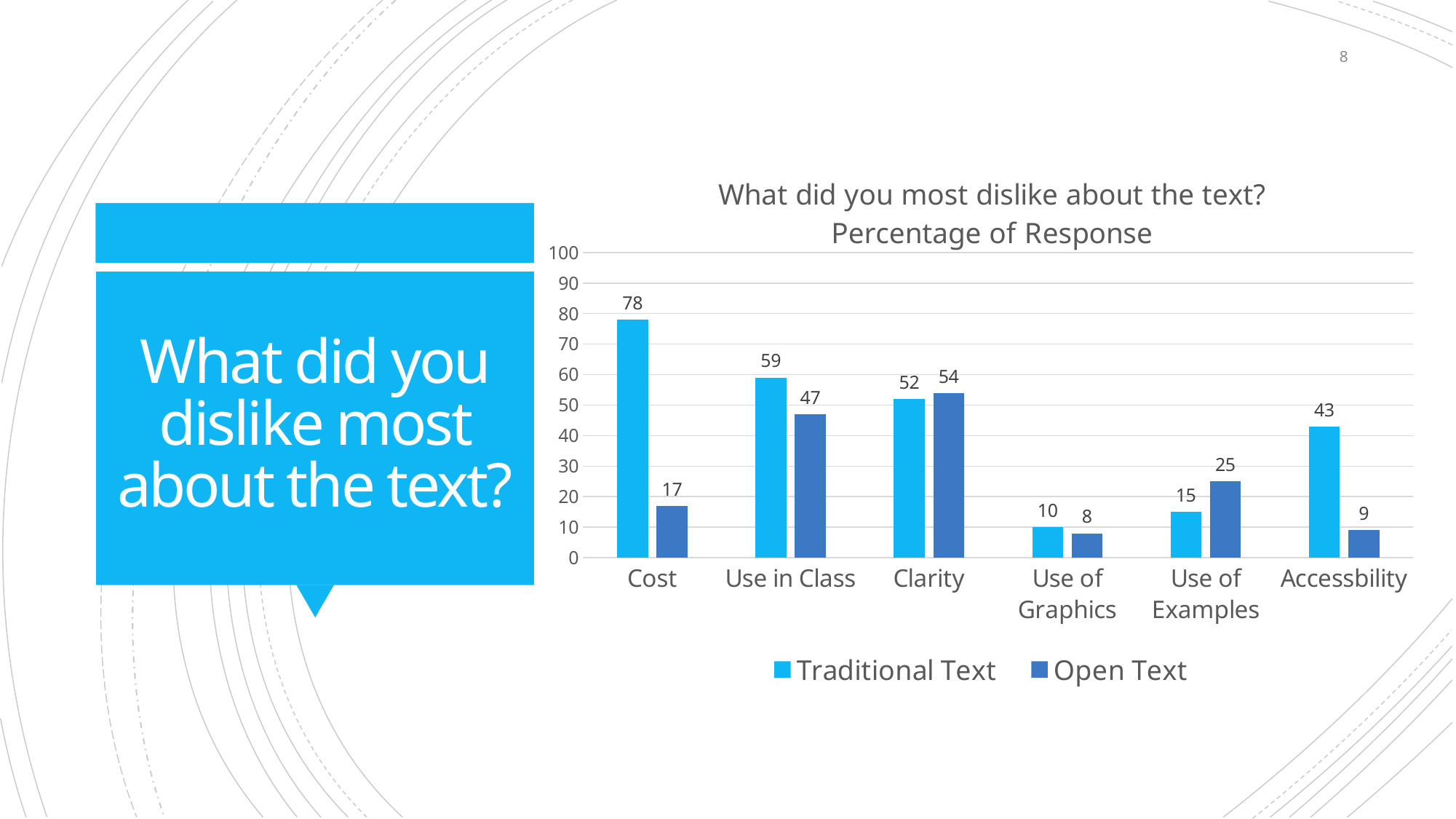
How many categories are shown on the x axis? 6 What is the Traditional Text value for Cost? 78 What is the title of the chart? What did you most dislike about the text? Percentage of Response What is the Open Text value for Use of Examples? 25 How many series does the legend list? 2 For Clarity, which series has the larger value, Traditional Text or Open Text? Open Text Is the Traditional Text value for Accessbility greater or less than 40? greater What is the Open Text value for Accessbility? 9 What is the difference between the Traditional Text and Open Text values for Cost? 61 Which category has the highest Traditional Text value? Cost Which category has the lowest Open Text value? Use of Graphics What kind of chart is shown on the slide? Bar chart